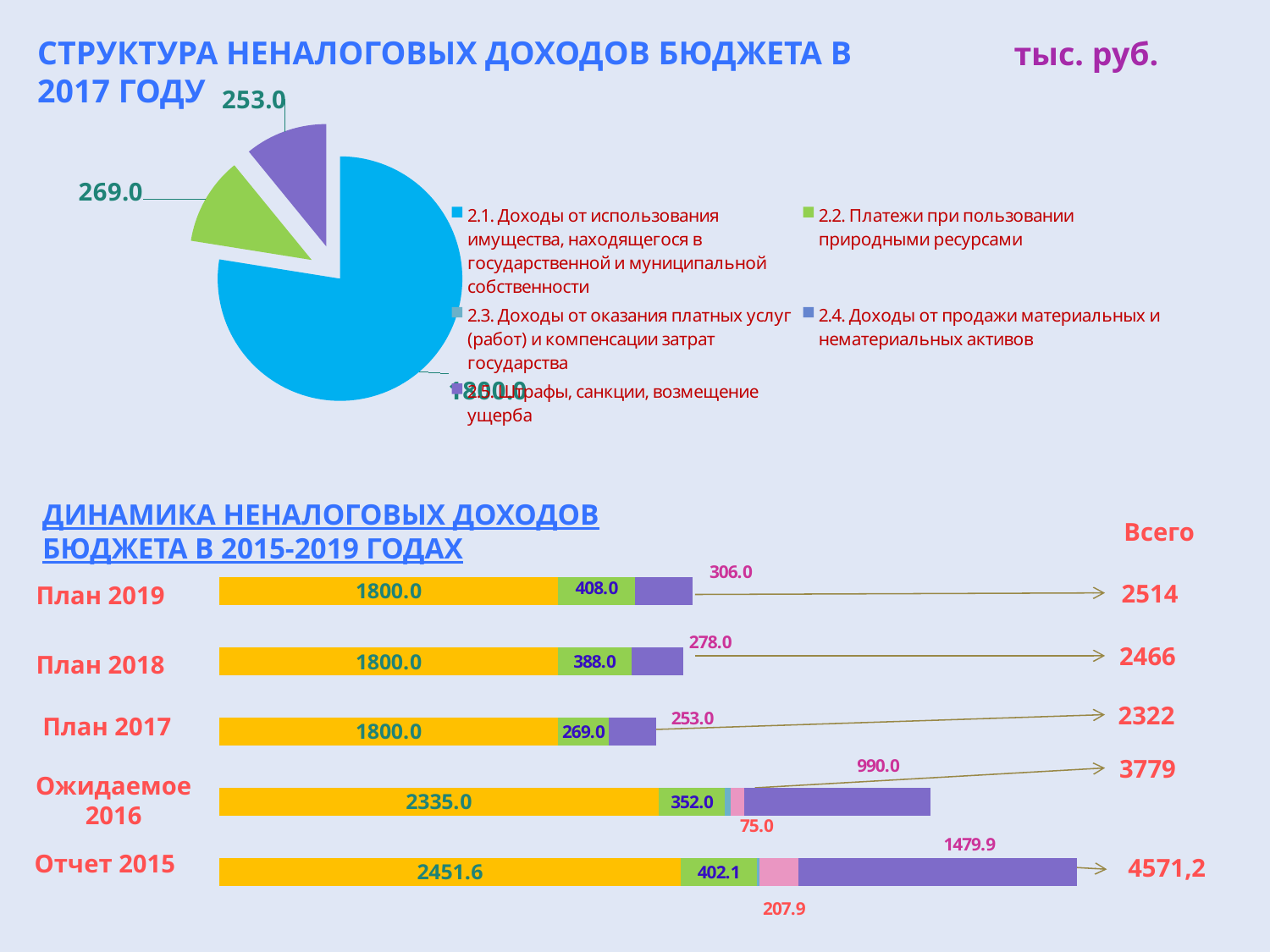
What kind of chart is the top chart titled 'СТРУКТУРА НЕНАЛОГОВЫХ ДОХОДОВ БЮДЖЕТА В 2017 ГОДУ'? pie chart In the bottom bar chart, which has the larger purple segment: 'Ожидаемое 2016' or 'Отчет 2015'? Отчет 2015 What kind of chart is the bottom chart titled 'ДИНАМИКА НЕНАЛОГОВЫХ ДОХОДОВ БЮДЖЕТА В 2015-2019 ГОДАХ'? bar chart In the bottom bar chart, which category has the lowest total ('Всего')? План 2017 In the top pie chart, what value is labelled on the green slice? 269.0 In the bottom bar chart, what is the value of the yellow segment for 'Отчет 2015'? 2451.6 In the top pie chart, what value is labelled on the purple slice? 253.0 In the bottom bar chart, what is the total ('Всего') for 'Ожидаемое 2016'? 3779 In the bottom bar chart, how many categories (rows) are shown? 5 In the top pie chart, how many entries does the legend list? 5 In the bottom bar chart, what is the difference between the green segment for 'План 2019' (408.0) and for 'План 2018' (388.0)? 20.0 In the bottom bar chart, which category has the highest total ('Всего')? Отчет 2015